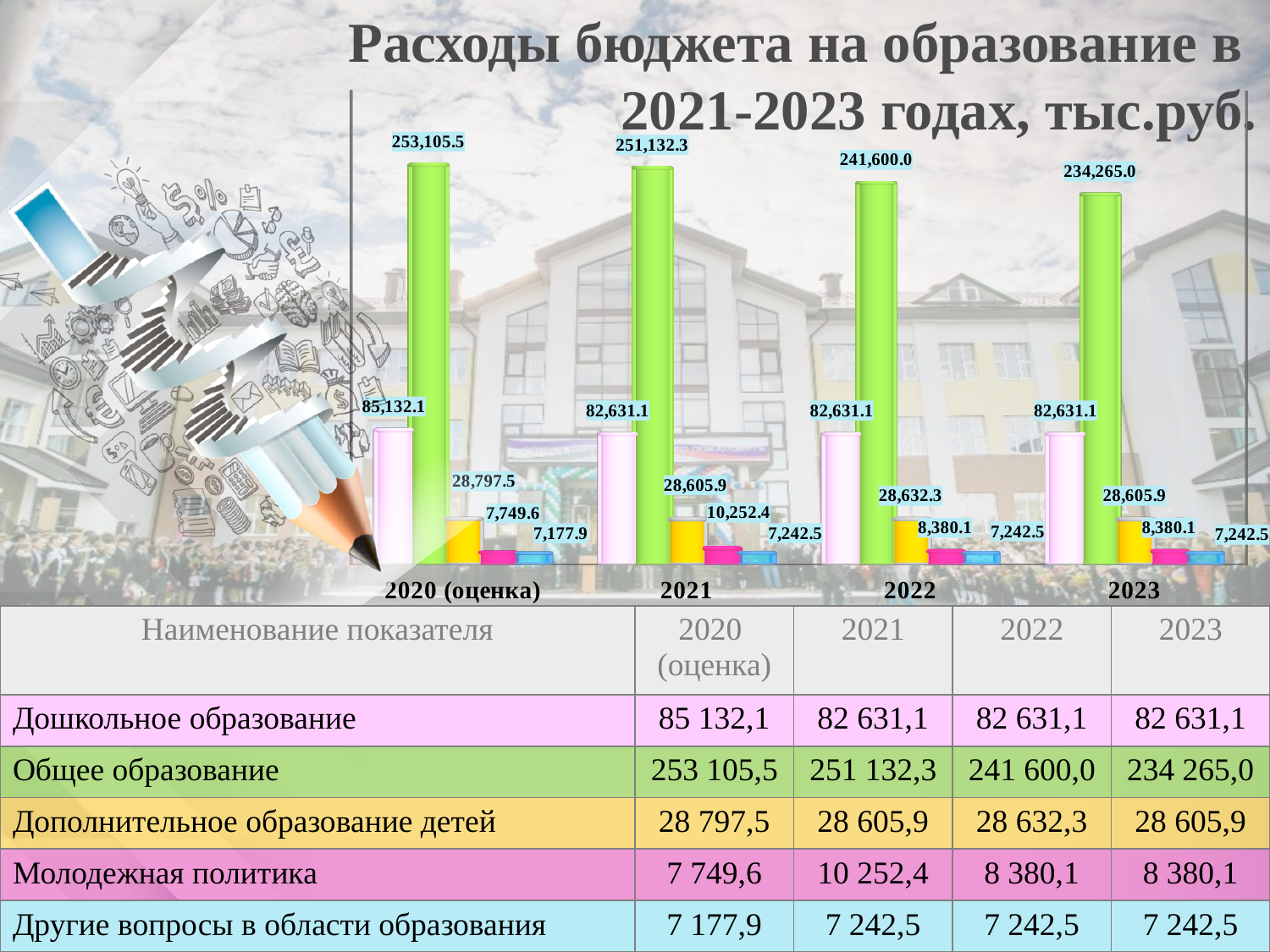
Which is larger: the Молодежная политика value for 2020 (оценка) or for 2021? 2021 In which year is the Общее образование bar the lowest? 2023 What is the value of the green bar (Общее образование) for 2021? 251,132.3 What is the value of the Дошкольное образование bar for 2020 (оценка)? 85,132.1 How many year categories are shown on the x axis of the chart? 4 What is the difference between the Общее образование values for 2020 (оценка) and 2023? 18,840.5 What is the difference between the Дошкольное образование values for 2020 (оценка) and 2021? 2,501.0 Do the Общее образование values rise or fall from 2020 (оценка) to 2023? fall In which year is the Общее образование bar the highest? 2020 (оценка) What type of chart is shown on the slide? bar chart What is the value of the Молодежная политика bar for 2021? 10,252.4 How many data series are plotted in the chart? 5